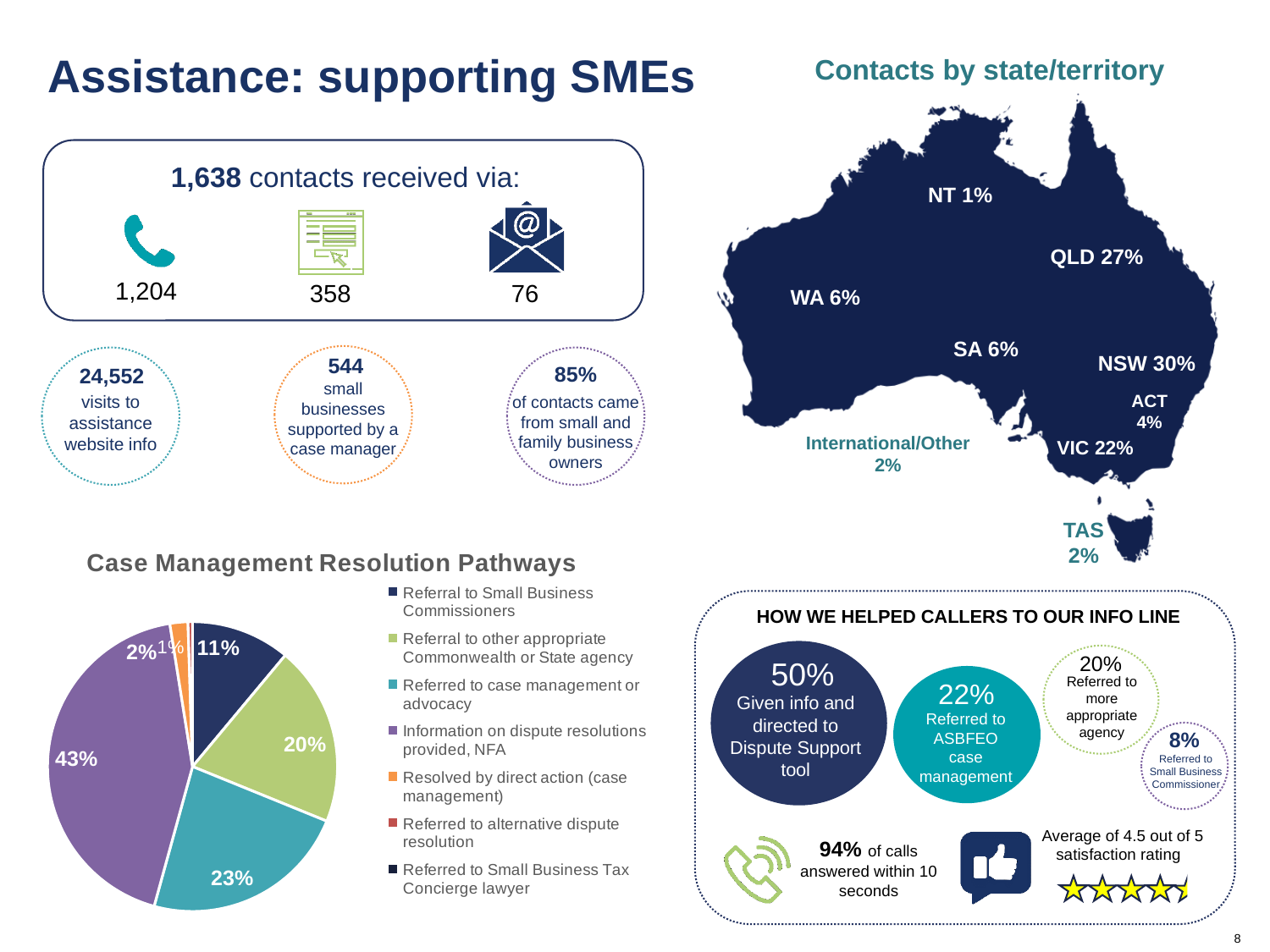
In the Case Management Resolution Pathways pie chart, which pathway has the largest share? Information on dispute resolutions provided, NFA In the Contacts by state/territory map, which state or territory has the highest share of contacts? NSW In the Case Management Resolution Pathways pie chart, what share is shown for Referral to other appropriate Commonwealth or State agency? 20% In the Case Management Resolution Pathways pie chart, how many entries does the legend list? 7 In the Case Management Resolution Pathways chart, what kind of chart is shown? pie chart In the Case Management Resolution Pathways pie chart, what colour is the slice for Information on dispute resolutions provided, NFA? purple In the Case Management Resolution Pathways pie chart, what share is shown for Information on dispute resolutions provided, NFA? 43% In the Case Management Resolution Pathways pie chart, what share is shown for Referred to case management or advocacy? 23% In the Case Management Resolution Pathways pie chart, which is larger: the share for Referral to Small Business Commissioners or the share for Referral to other appropriate Commonwealth or State agency? Referral to other appropriate Commonwealth or State agency In the Case Management Resolution Pathways pie chart, what share is shown for Resolved by direct action (case management)? 2% In the Case Management Resolution Pathways pie chart, what share is shown for Referral to Small Business Commissioners? 11% In the Case Management Resolution Pathways pie chart, what is the difference between the shares for Information on dispute resolutions provided, NFA and Referred to case management or advocacy? 20%